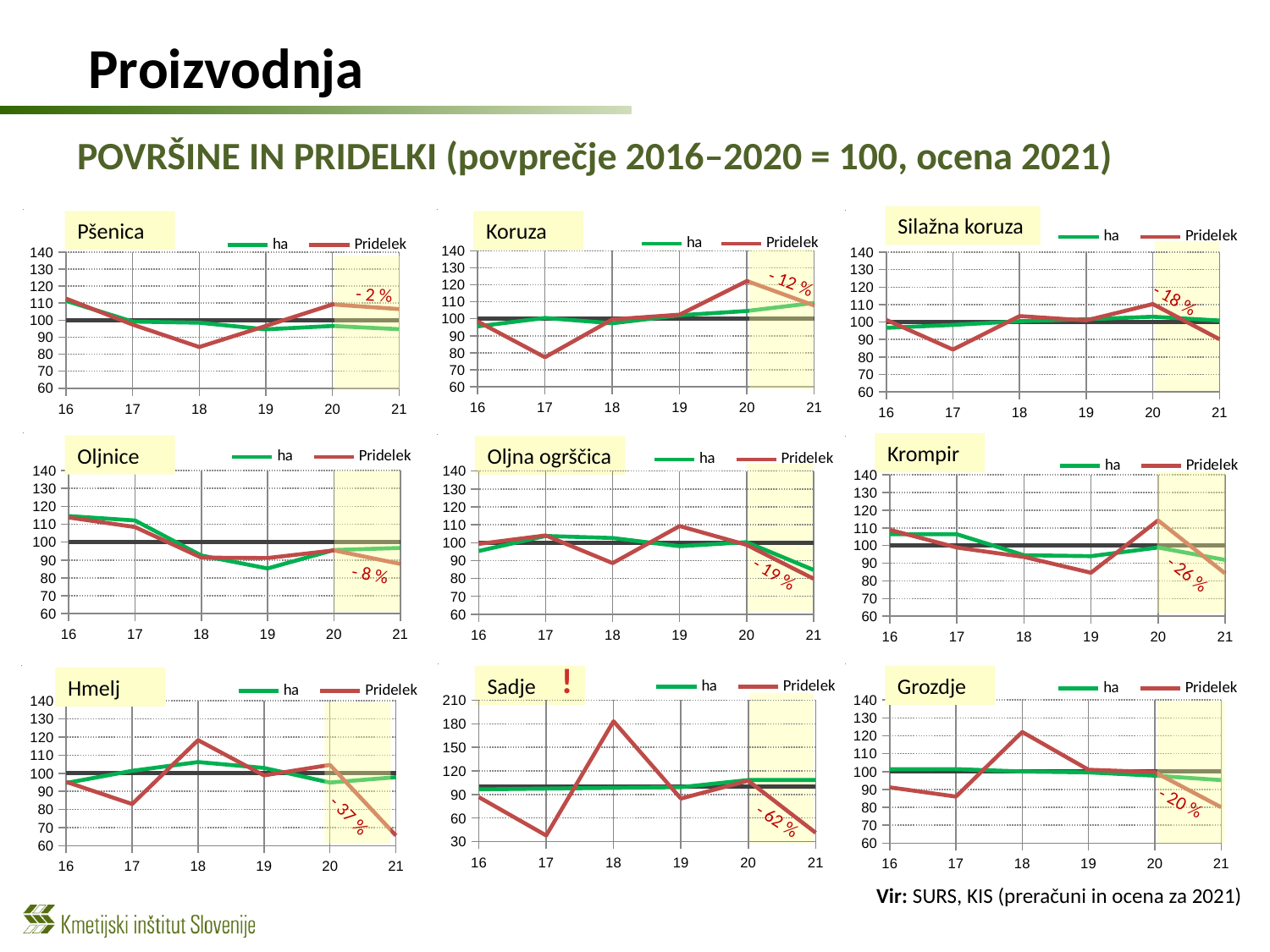
In the Koruza chart, is the Pridelek value for 17 greater or less than 90? less In the Grozdje chart, is the Pridelek value for 18 greater or less than 110? greater How many charts are shown on the slide? 9 In the Sadje chart, in which year is the Pridelek value highest? 18 In the Sadje chart, in which year is the Pridelek value lowest? 17 In the Oljnice chart, does the ha series rise or fall from 16 to 19? fall What percentage change is annotated in the shaded 2021 area of the Hmelj chart? - 37 % What kind of chart is the Pšenica chart? line chart How many points along the x axis does the Krompir chart show? 6 In the Sadje chart, is the Pridelek value for 18 greater or less than 150? greater In the Koruza chart, which series has the larger value in 17, ha or Pridelek? ha How many series does the legend of the Koruza chart list? 2